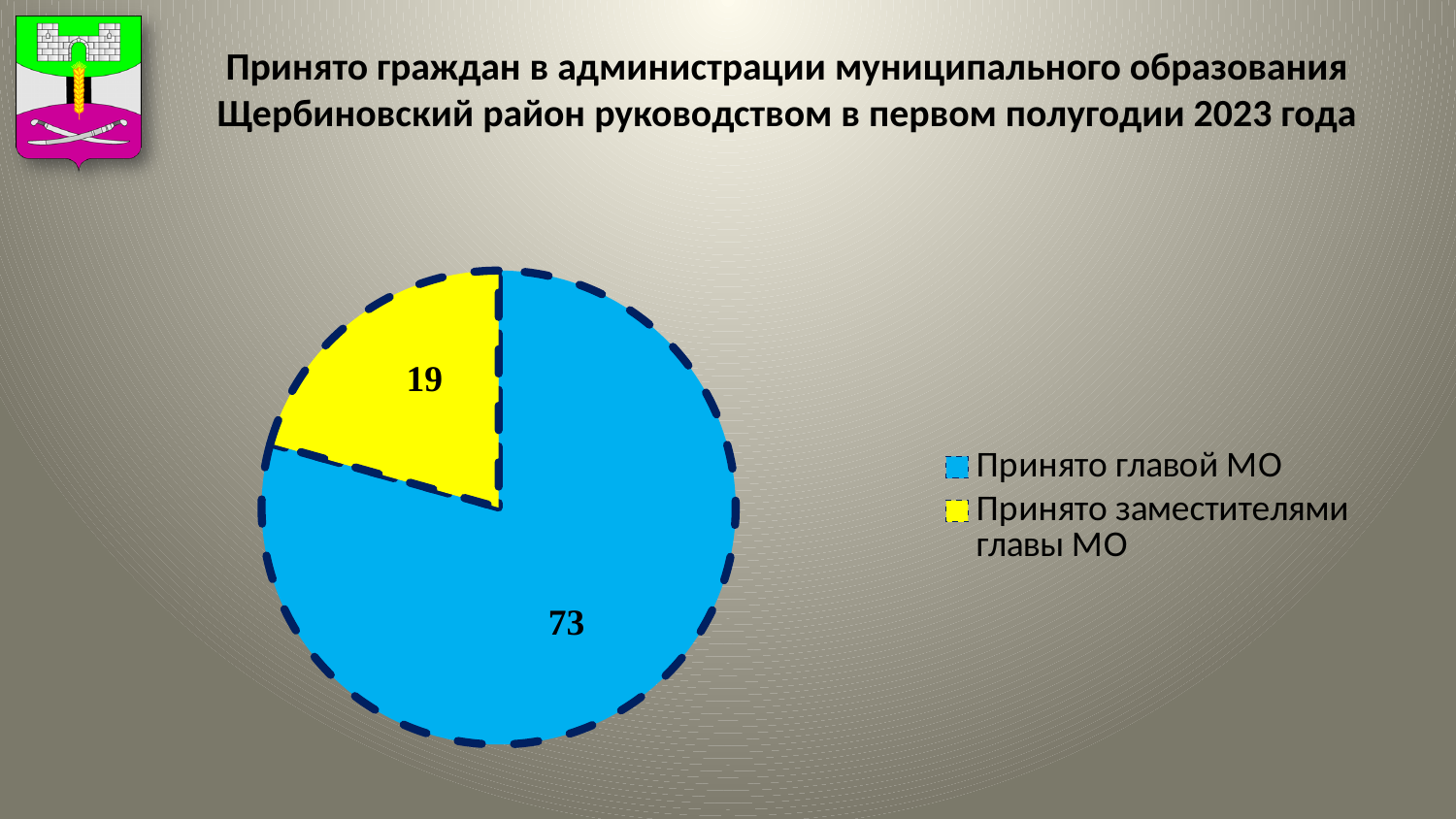
What is the total of all slices in the pie chart? 92 What is the difference between the number received by the head of the municipality and the number received by the deputy heads? 54 What colour is the slice for Принято главой МО? blue What colour is the slice for Принято заместителями главы МО? yellow Which category has the smallest slice of the pie? Принято заместителями главы МО What type of chart is shown on the slide? pie chart How many citizens were received by the head of the municipality (Принято главой МО)? 73 How many entries does the legend list? 2 How many slices does the pie chart have? 2 Which is larger: the value for Принято главой МО or the value for Принято заместителями главы МО? Принято главой МО How many citizens were received by the deputy heads of the municipality (Принято заместителями главы МО)? 19 Which category has the largest slice of the pie? Принято главой МО